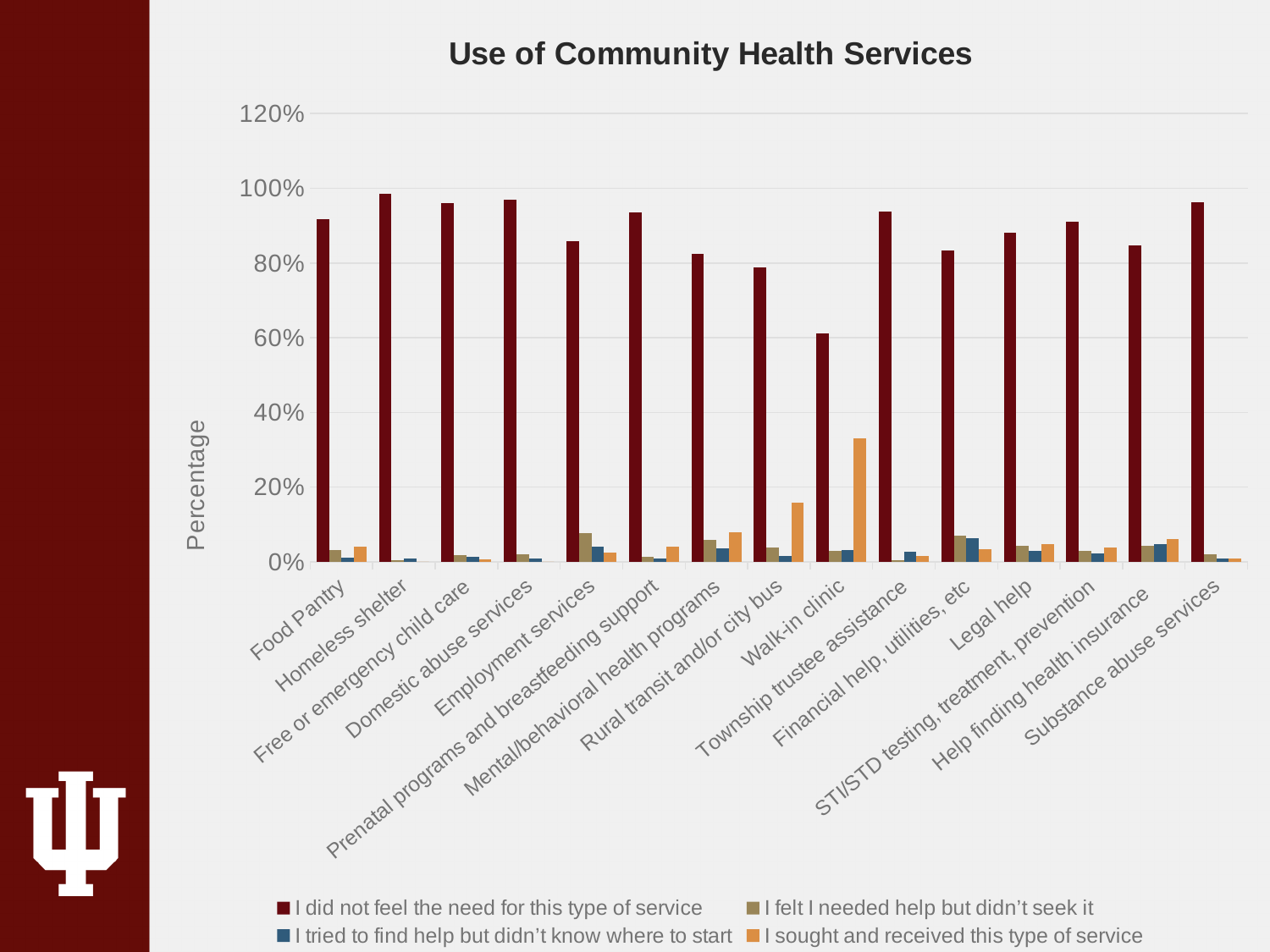
Is the value for 'I did not feel the need for this type of service' for Food Pantry greater or less than 80%? greater For 'I did not feel the need for this type of service', which is larger: Food Pantry or Walk-in clinic? Food Pantry What is the title of the chart? Use of Community Health Services What type of chart is shown on the slide? bar chart Is the value for 'I sought and received this type of service' for Walk-in clinic greater or less than 20%? greater Which category has the highest value for 'I sought and received this type of service'? Walk-in clinic How many service categories are shown on the x axis? 15 Which category has the lowest value for 'I did not feel the need for this type of service'? Walk-in clinic Is the value for 'I did not feel the need for this type of service' for Walk-in clinic greater or less than 80%? less What is the label of the y axis? Percentage How many series does the legend list? 4